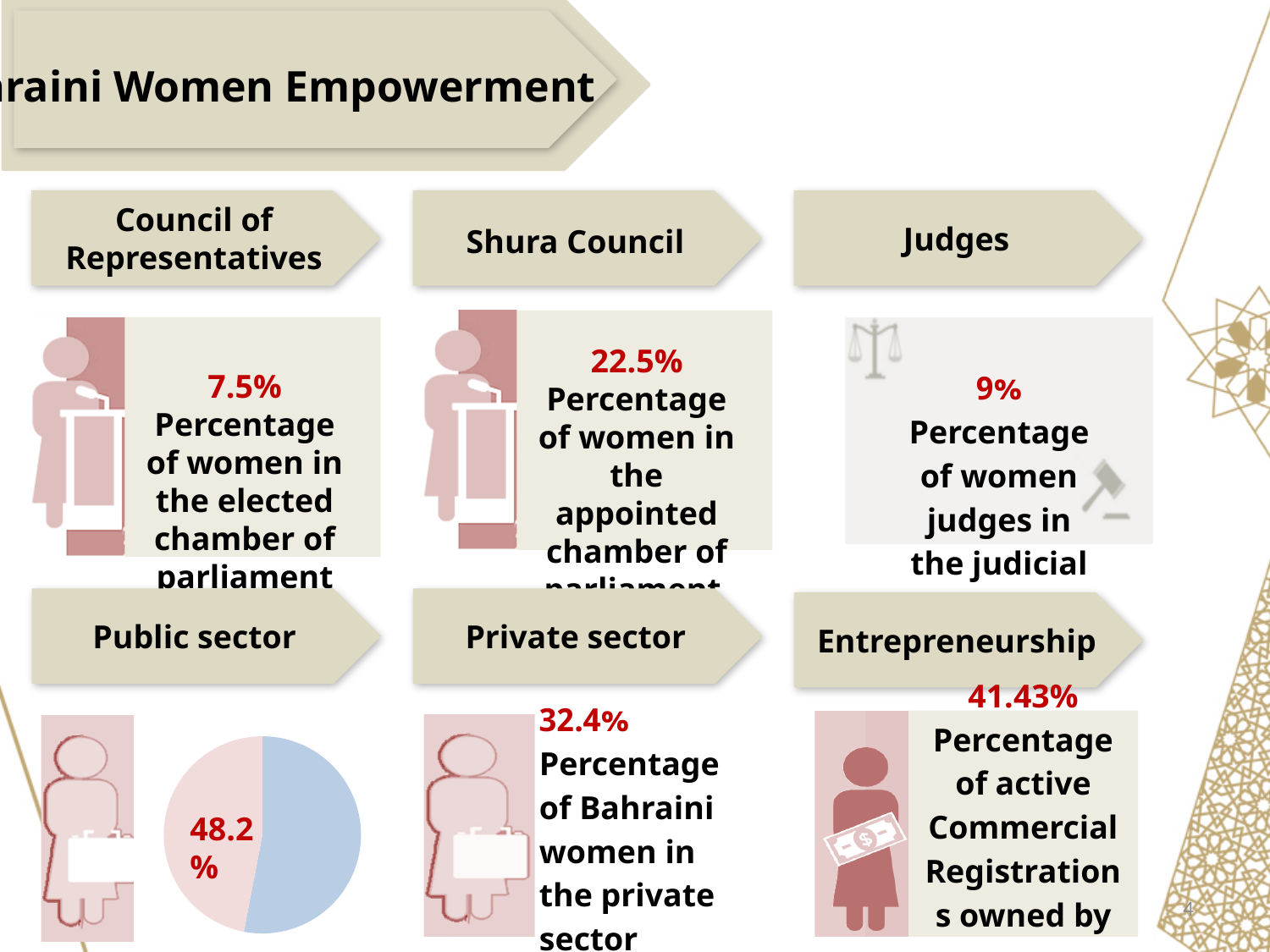
In the Public sector pie chart, what value is printed on the labelled slice? 48.2% Under which section heading does the pie chart on the slide appear? Public sector What kind of chart is shown in the Public sector section of the slide? pie chart Is the labelled slice of the Public sector pie chart greater or less than 50%? less How many slices does the Public sector pie chart have? 2 What colour is the slice labelled 48.2% in the Public sector pie chart? pink